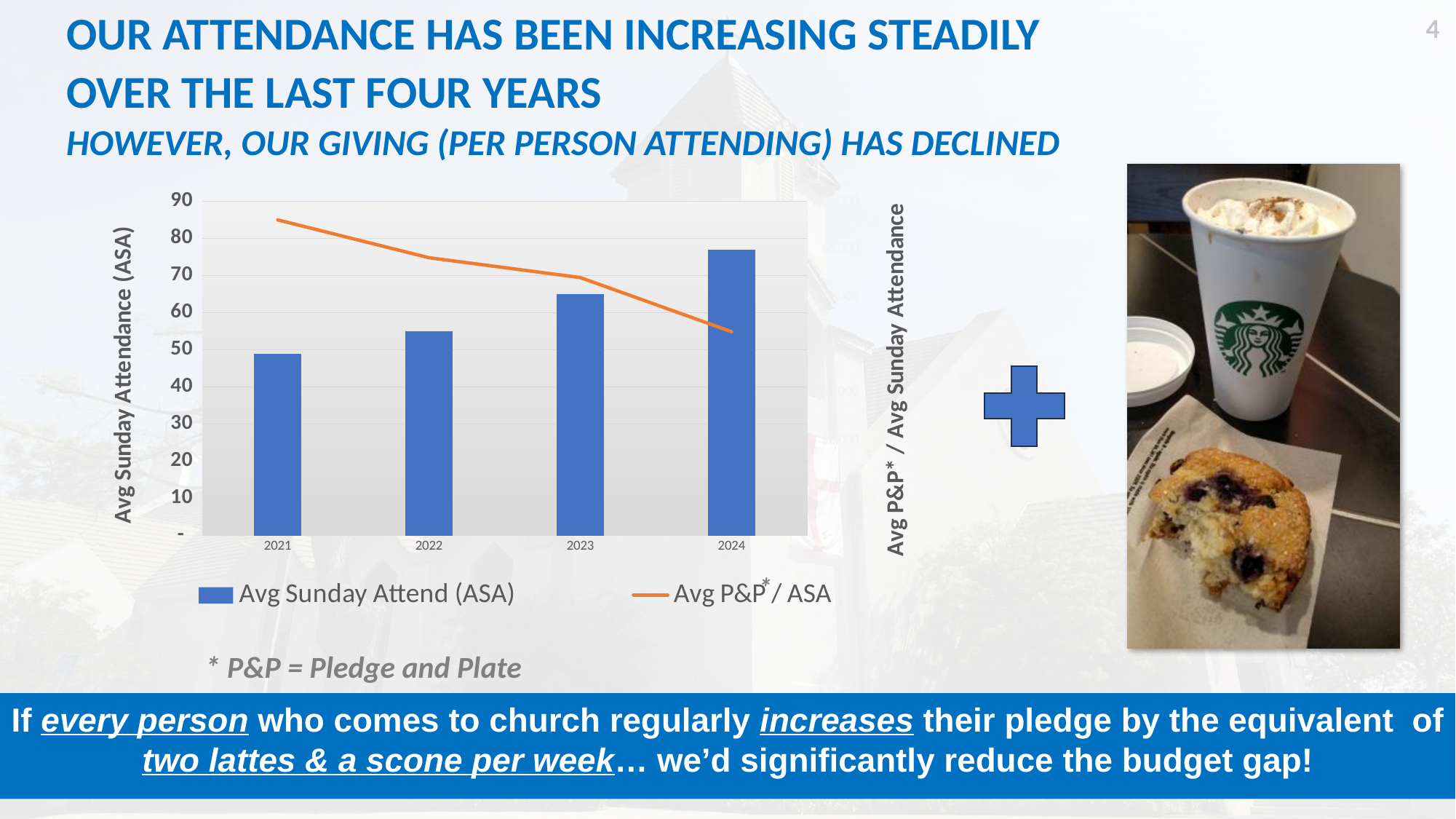
Do the Avg Sunday Attend (ASA) bars rise or fall from 2021 to 2024? Rise What kind of chart is shown on the slide? A combined bar and line chart How many years are shown on the x axis of the chart? 4 How many series does the chart legend list? 2 Does the Avg P&P / ASA line rise or fall from 2021 to 2024? Fall Is the Avg Sunday Attend (ASA) value for 2024 greater or less than 70? greater What is the title of the left vertical axis of the chart? Avg Sunday Attendance (ASA) Is the Avg Sunday Attend (ASA) value for 2023 greater or less than 60? greater Which year has the highest Avg Sunday Attend (ASA) bar? 2024 Is the Avg Sunday Attend (ASA) value for 2021 greater or less than 60? less Which year has the larger Avg Sunday Attend (ASA) bar, 2022 or 2023? 2023 Which year has the lowest Avg Sunday Attend (ASA) bar? 2021